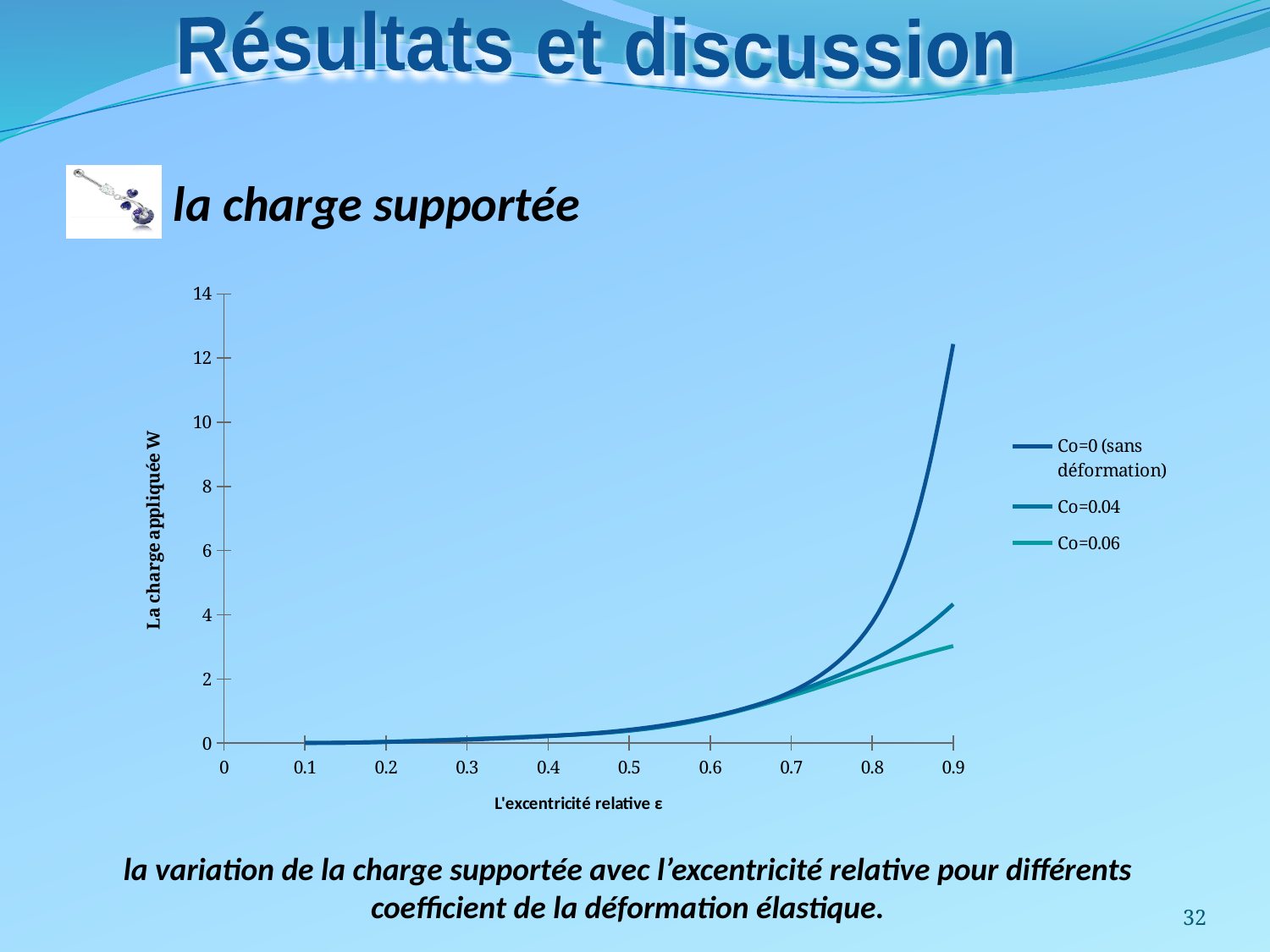
At ε = 0.9, is the value for Co=0.06 greater or less than 4? less Which series has the lowest value at ε = 0.9? Co=0.06 Which series reaches the highest value at ε = 0.9? Co=0 (sans déformation) At ε = 0.9, is the value for Co=0.04 greater or less than 6? less How many series does the legend list? 3 At ε = 0.9, is the value for Co=0 (sans déformation) greater or less than 10? greater What is the title of the y axis? La charge appliquée W What kind of chart is shown on the slide? line chart What is the title of the x axis? L'excentricité relative ε Do the values rise or fall as the relative eccentricity ε increases? rise At ε = 0.9, which is larger: the value for Co=0 (sans déformation) or the value for Co=0.04? Co=0 (sans déformation)